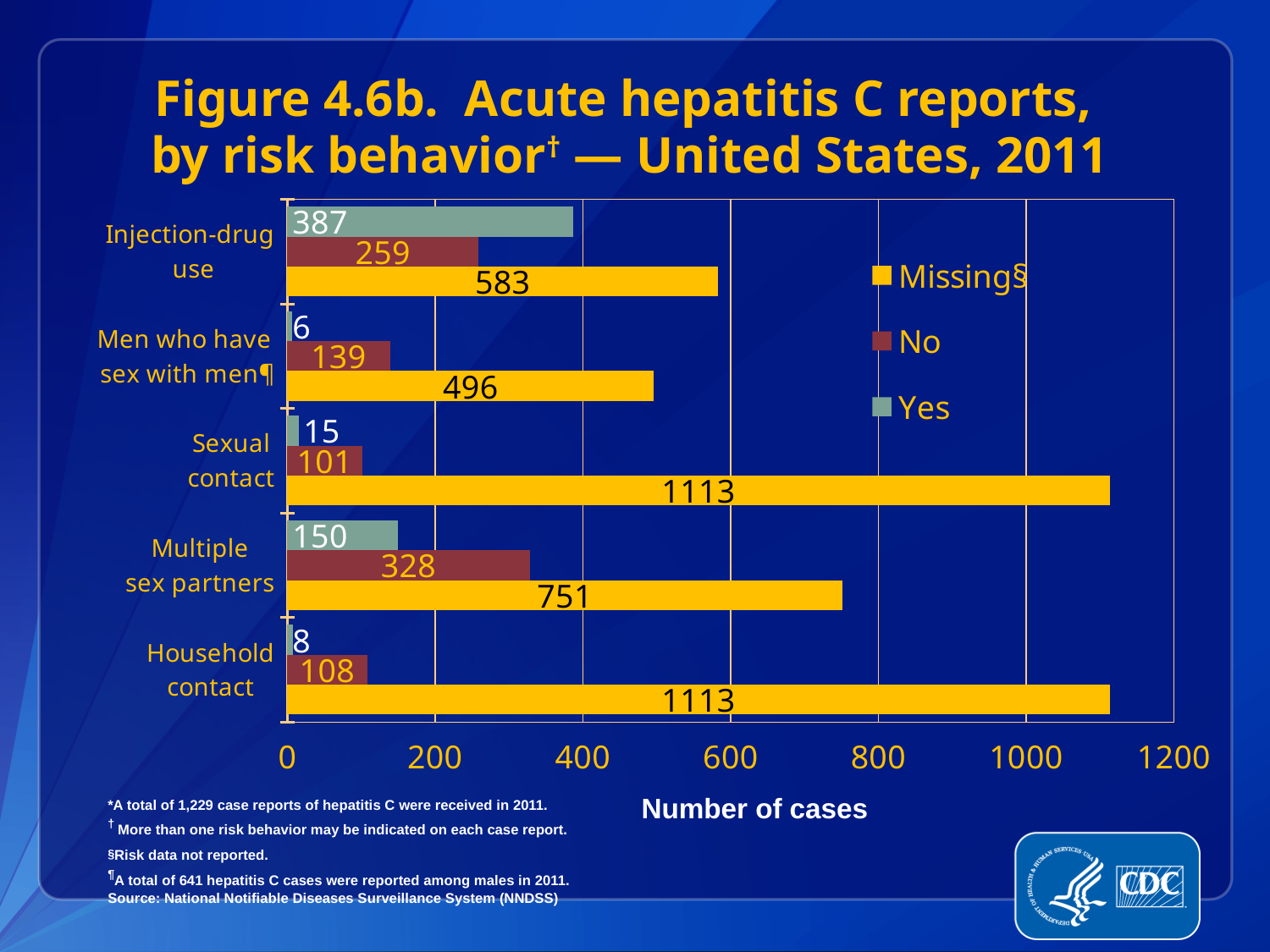
How many risk behavior categories are shown on the chart? 5 Which risk behavior has the highest 'Yes' value? Injection-drug use What is the difference between the 'No' values for Multiple sex partners and Injection-drug use? 69 What is the label of the x axis? Number of cases What is the number of cases with 'Yes' for Injection-drug use? 387 What is the number of cases with 'Yes' for Household contact? 8 What is the number of cases with 'No' for Multiple sex partners? 328 Which is larger: the 'Missing' value for Multiple sex partners or for Injection-drug use? Multiple sex partners How many series does the legend list? 3 What kind of chart is shown on the slide? Bar chart Which risk behavior has the lowest 'Yes' value? Men who have sex with men What is the number of cases with 'Missing' for Sexual contact? 1113